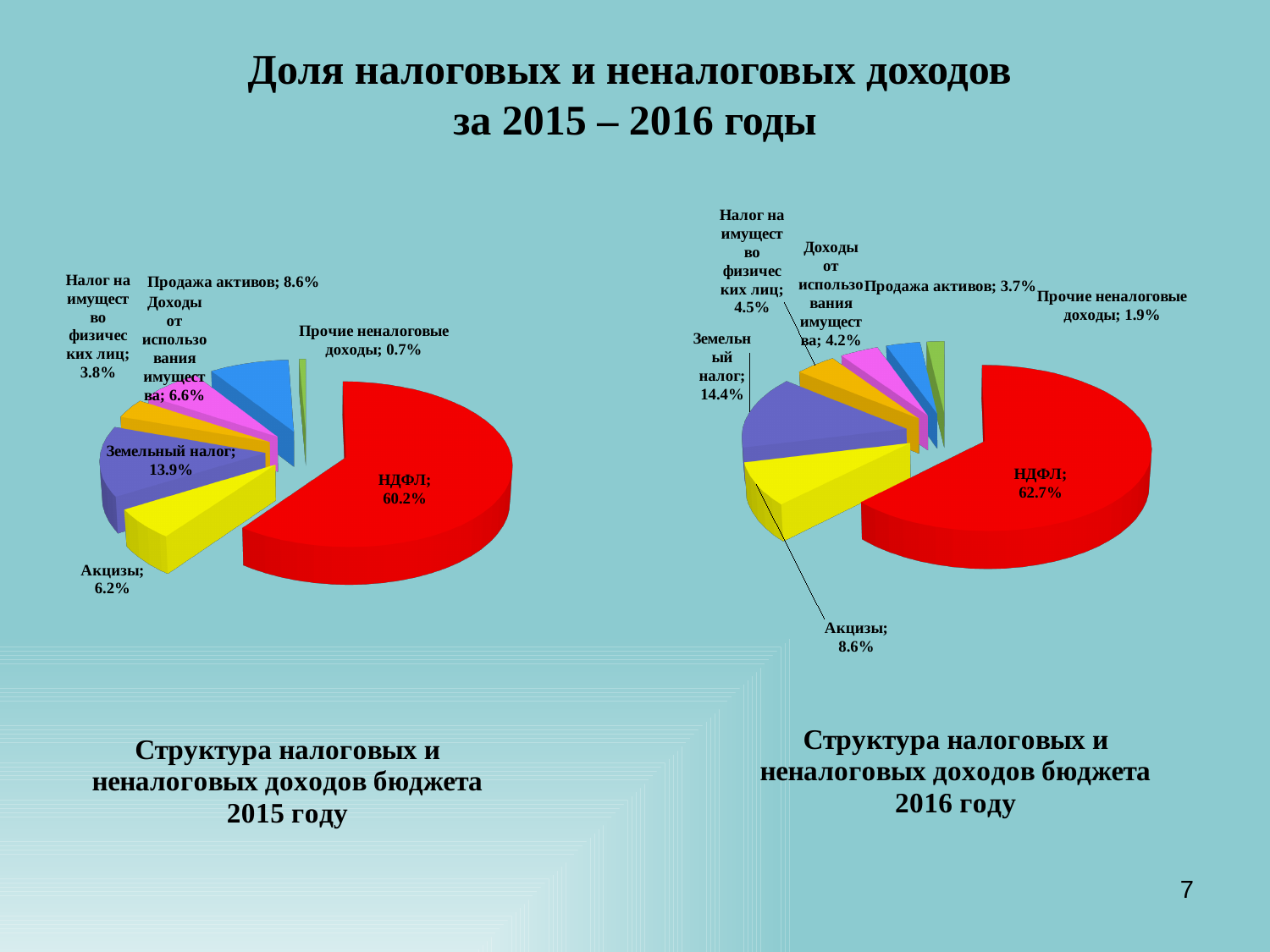
On the 2015 pie chart (left), what share does НДФЛ have? 60.2% What type of chart is used on the left side of the slide for 2015? Pie chart On the 2015 pie chart (left), which category has the smallest share? Прочие неналоговые доходы How many slices does the 2016 pie chart (right) have? 7 On the 2016 pie chart (right), what is the share of Продажа активов? 3.7% What is the difference between the НДФЛ share in 2016 (right chart) and in 2015 (left chart)? 2.5% On the 2016 pie chart (right), which category has the smallest share? Прочие неналоговые доходы On the 2015 pie chart (left), what is the share of Прочие неналоговые доходы? 0.7% On the 2016 pie chart (right), what share does Земельный налог have? 14.4% On the 2015 pie chart (left), which is larger: Земельный налог or Продажа активов? Земельный налог On the 2016 pie chart (right), what colour is the НДФЛ slice? Red On the 2015 pie chart (left), which category has the largest share? НДФЛ